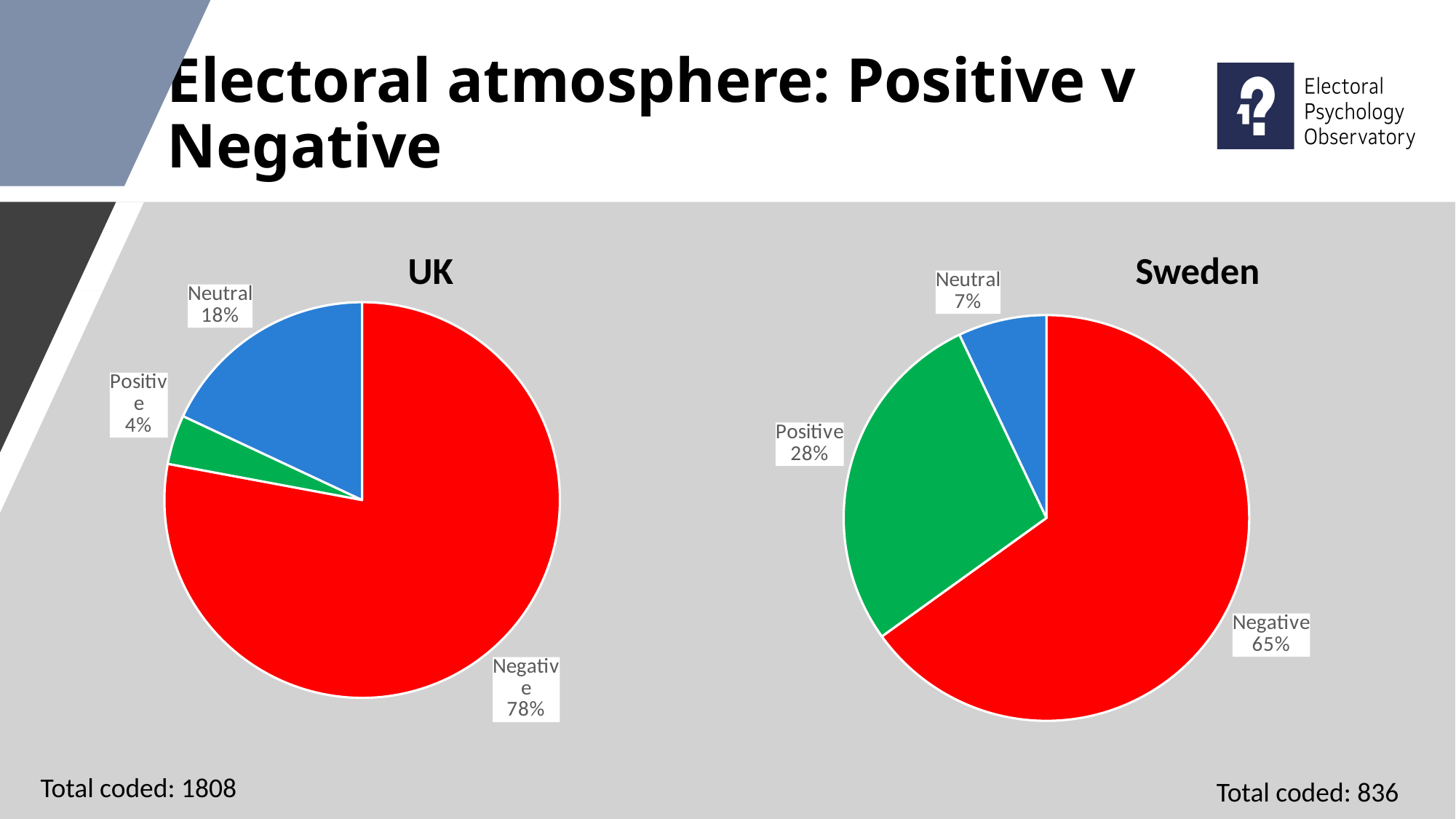
In the UK chart, which category has the smallest slice? Positive How many slices does the UK pie chart have? 3 In the UK chart, what share of the pie is Negative? 78% Which is larger: the Positive share in the UK chart or the Positive share in the Sweden chart? Sweden In the Sweden chart, which category has the largest slice? Negative What kind of chart is the Sweden chart? Pie chart In the UK chart, what is the value for Neutral? 18% In the Sweden chart, what is the combined share of Positive and Neutral? 35% What is the total coded figure shown below the UK chart? 1808 In the Sweden chart, what share of the pie is Positive? 28% In the Sweden chart, what is the value for Neutral? 7% What is the difference between the Negative share in the UK chart and the Negative share in the Sweden chart? 13%